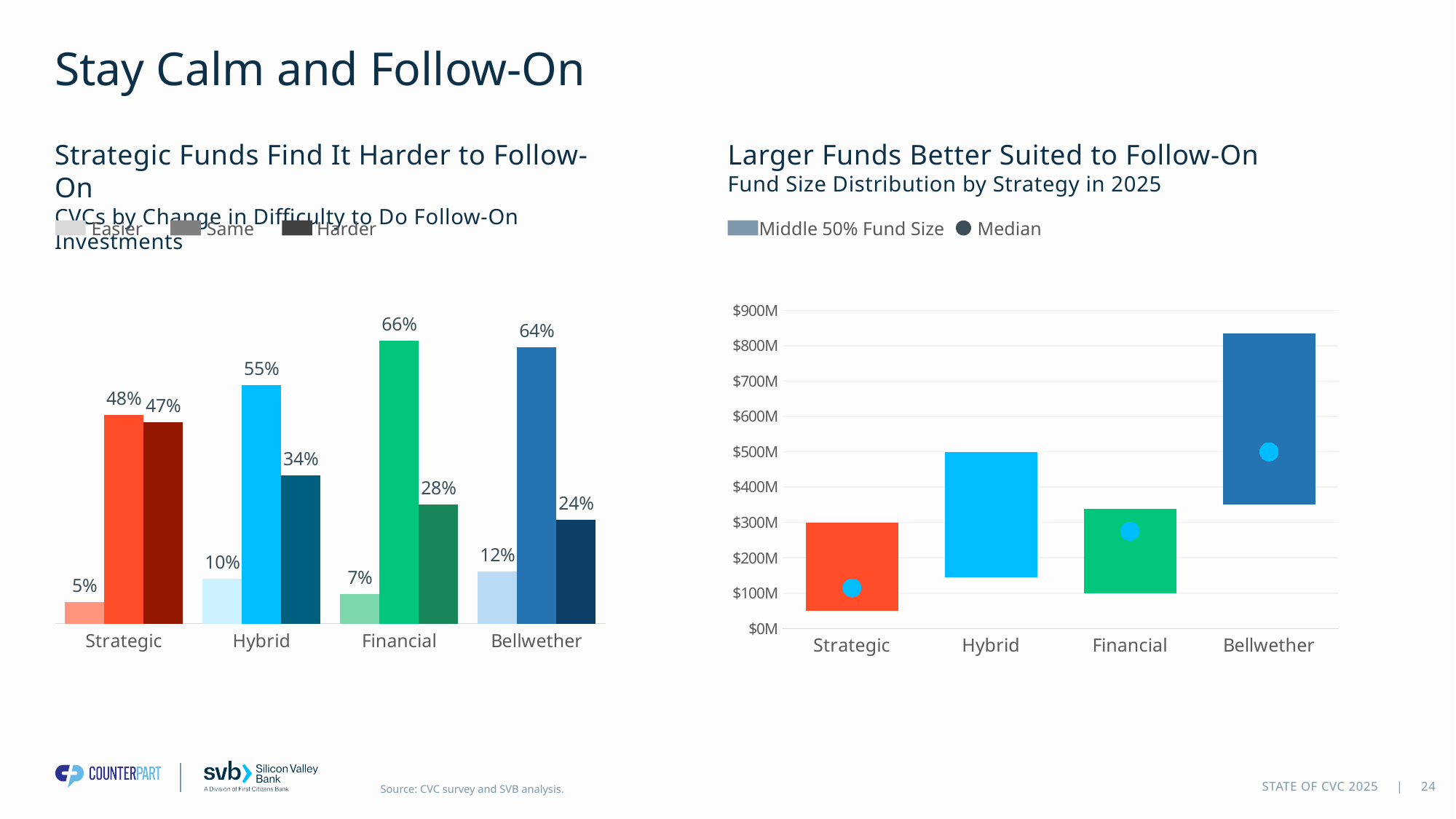
In the left chart, what percentage of Strategic CVCs said follow-on investments are Harder? 47% In the left chart, which category has the highest Harder percentage? Strategic In the right chart, is the median fund size for Bellwether greater or less than $400M? greater How many categories are shown on the x axis of the right chart? 4 In the right chart, is the median fund size for Strategic greater or less than $200M? less In the left chart, which category has the lowest Easier percentage? Strategic What kind of chart is the left chart? Bar chart In the left chart, what percentage of Bellwether CVCs said follow-on investments are Easier? 12% How many series does the legend of the left chart list? 3 In the left chart, what percentage of Financial CVCs said follow-on difficulty is the Same? 66% In the left chart, which is larger: the Harder percentage for Hybrid or for Financial? Hybrid In the left chart, what is the difference between the Same percentages for Hybrid and Strategic? 7%